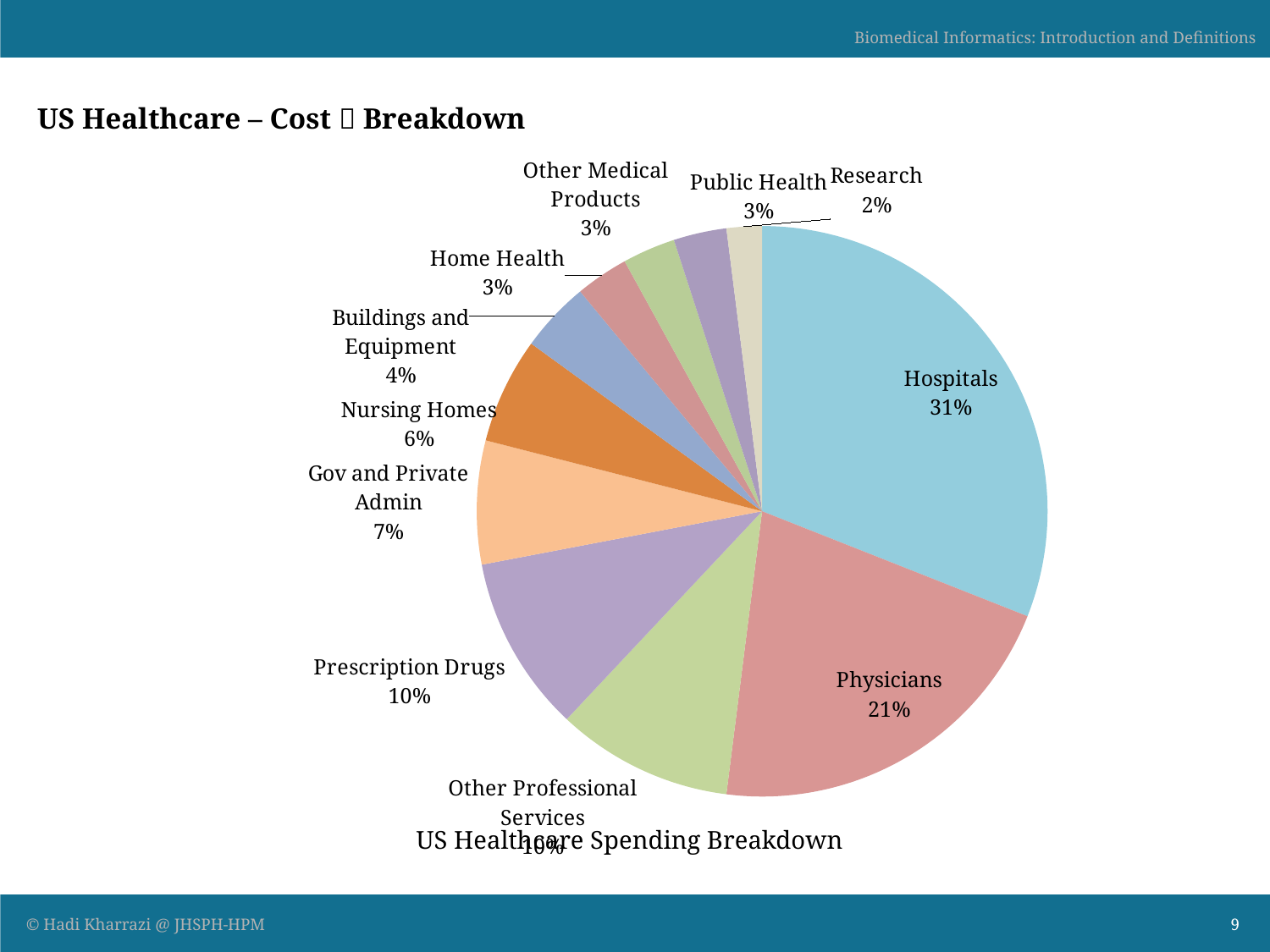
What kind of chart is shown on the slide? pie chart How many categories are shown in the pie chart? 11 What percentage of spending is attributed to Physicians? 21% Which is larger, the share for Nursing Homes or the share for Buildings and Equipment? Nursing Homes What is the title of the chart? US Healthcare Spending Breakdown What is the value shown for Prescription Drugs? 10% What is the difference in percentage points between Hospitals and Physicians? 10 What percentage is shown for Nursing Homes? 6% What share of US healthcare spending goes to Hospitals? 31% Which category has the smallest share of spending? Research Which category has the largest share of spending? Hospitals What is the value for Gov and Private Admin? 7%